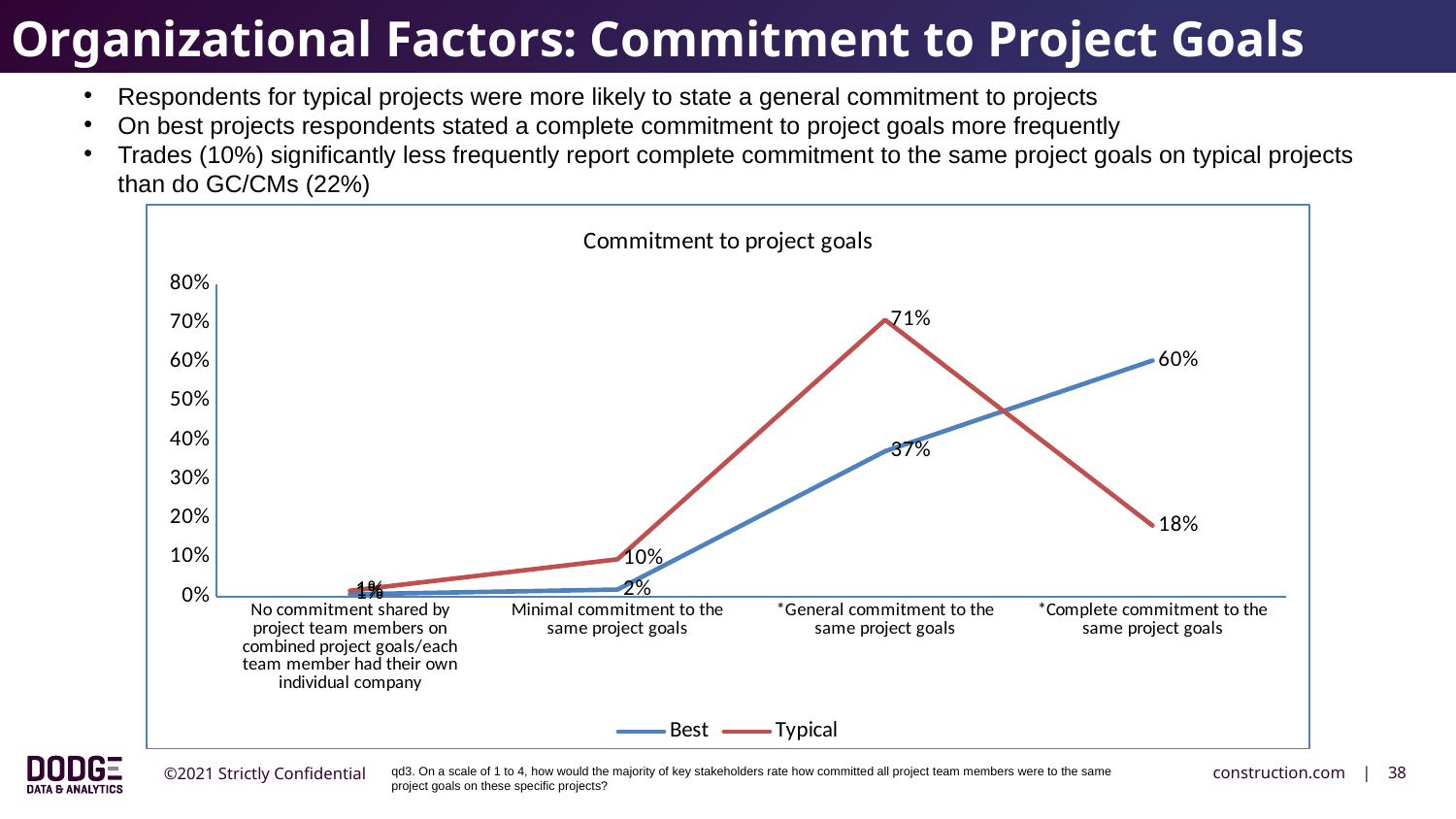
For '*Complete commitment to the same project goals', which series has the larger value, Best or Typical? Best What is the Best value for '*General commitment to the same project goals'? 37% Which category has the highest Typical value? *General commitment to the same project goals What is the difference between the Typical and Best values for '*General commitment to the same project goals'? 34% What is the Typical value for 'Minimal commitment to the same project goals'? 10% What type of chart is shown on the slide? Line chart Which series is drawn in red in the chart? Typical What is the Typical value for '*General commitment to the same project goals'? 71% Which category has the highest Best value? *Complete commitment to the same project goals How many categories are shown on the x axis of the chart? 4 What is the Best value for '*Complete commitment to the same project goals'? 60% How many series does the legend list in the 'Commitment to project goals' chart? 2